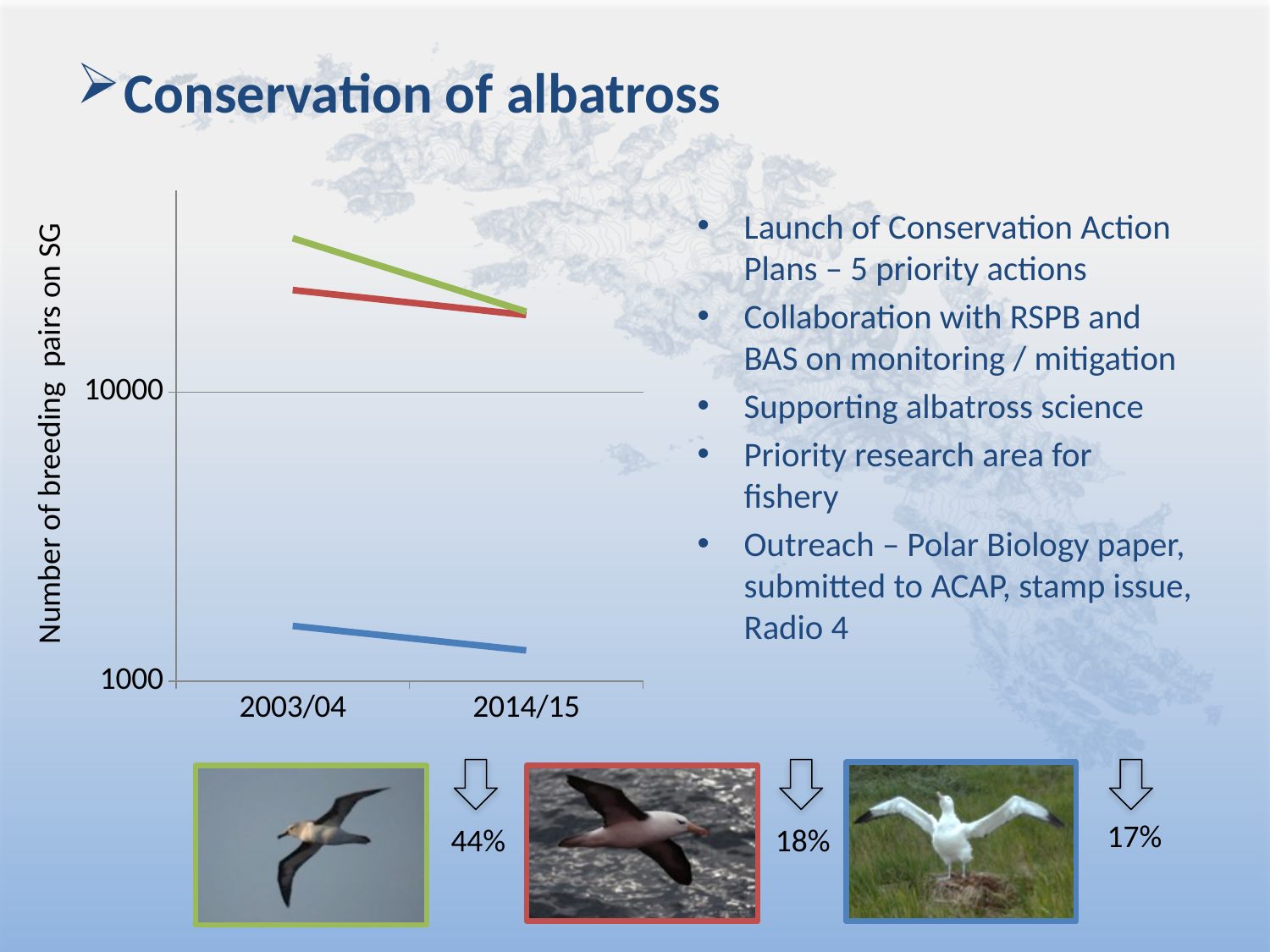
What is the label of the y axis of the chart? Number of breeding pairs on SG At 2003/04, which line has the higher value, the green line or the red line? green line Is the value of the blue line at 2014/15 greater or less than 1000? greater Which line has the lowest values on the chart? blue line Is the value of the blue line at 2003/04 greater or less than 10000? less What kind of chart is shown on the slide? line chart What are the two x-axis labels on the chart? 2003/04 and 2014/15 How many time periods are shown on the x axis of the chart? 2 Is the value of the red line at 2014/15 greater or less than 10000? greater How many lines are plotted on the chart? 3 Do the plotted lines rise or fall from 2003/04 to 2014/15? fall